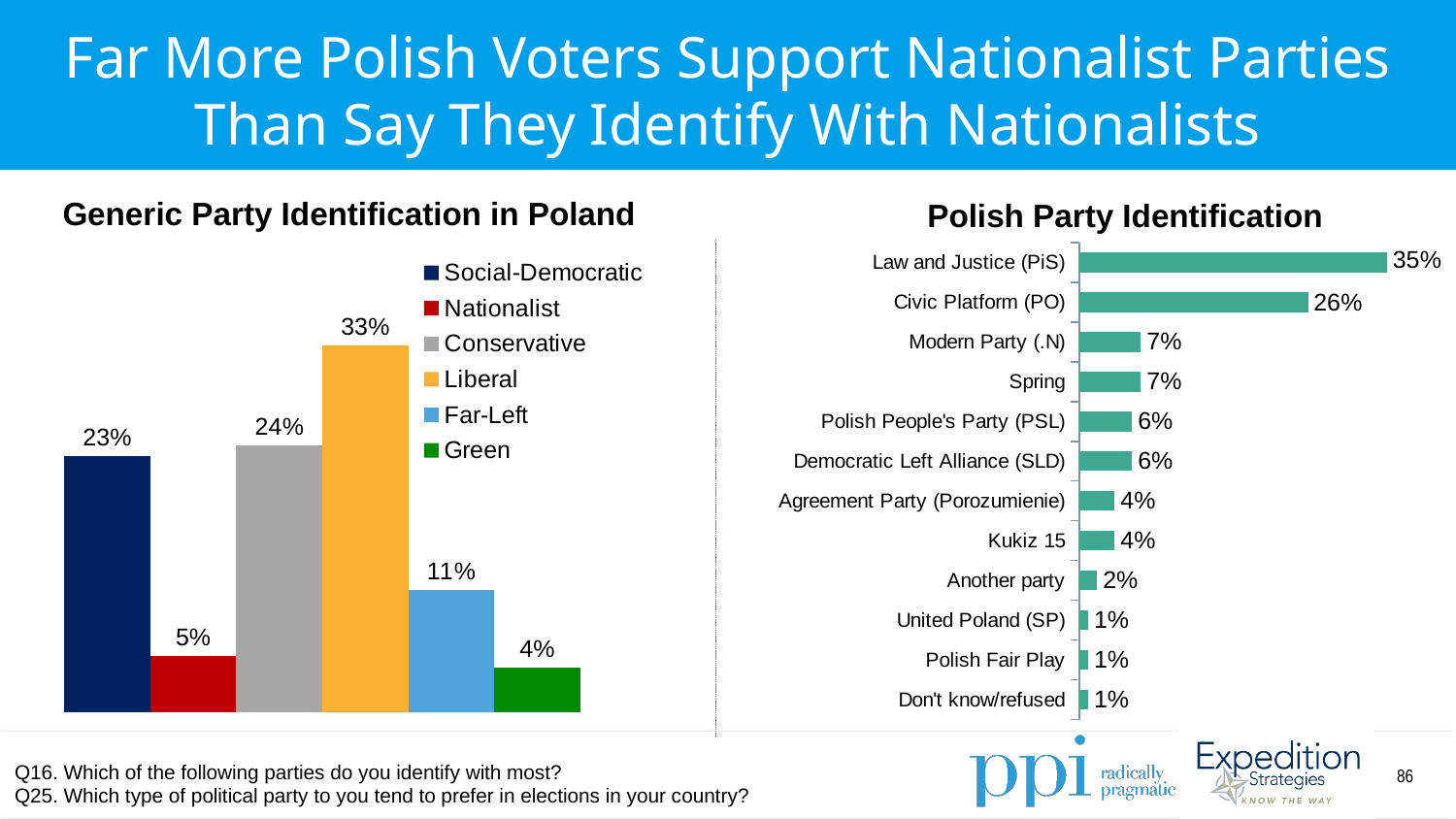
In the 'Generic Party Identification in Poland' chart, how many series does the legend list? 6 In the 'Generic Party Identification in Poland' chart, what is the value for Liberal? 33% In the 'Polish Party Identification' chart, which is larger: Kukiz 15 or Another party? Kukiz 15 In the 'Polish Party Identification' chart, how many categories are plotted? 12 In the 'Polish Party Identification' chart, what is the value for Civic Platform (PO)? 26% In the 'Polish Party Identification' chart, which party has the highest value? Law and Justice (PiS) In the 'Generic Party Identification in Poland' chart, which category has the lowest value? Green In the 'Generic Party Identification in Poland' chart, what is the value for Nationalist? 5% In the 'Polish Party Identification' chart, what is the difference between Law and Justice (PiS) and Civic Platform (PO)? 9% In the 'Generic Party Identification in Poland' chart, what is the difference between Conservative and Social-Democratic? 1% What kind of chart is the 'Polish Party Identification' chart? Bar chart In the 'Generic Party Identification in Poland' chart, what colour is the Far-Left bar? Light blue